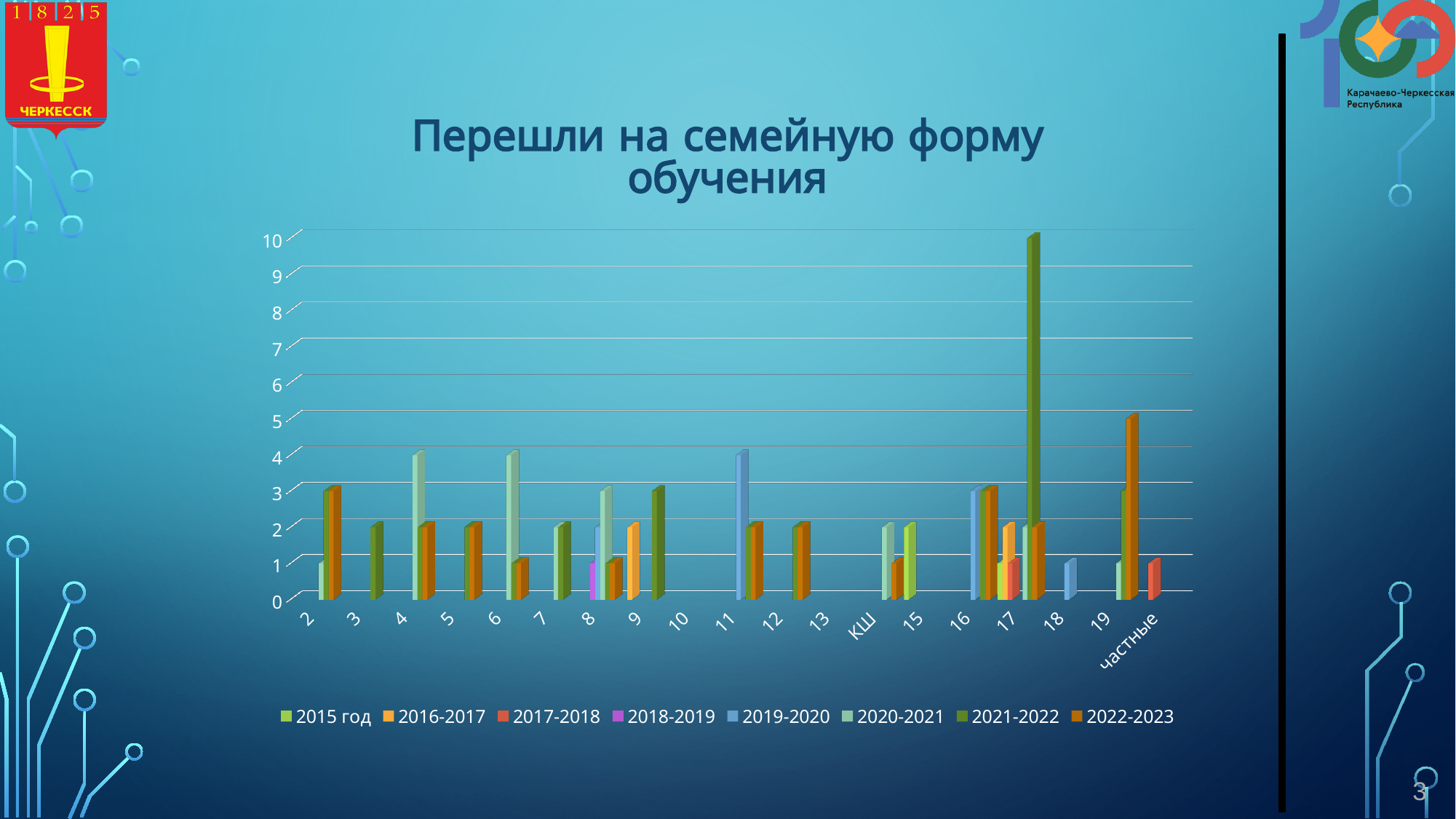
Is the value for 2021-2022 in category 17 greater or less than 8? greater Is the value for 2019-2020 in category 11 greater or less than 3? greater Which category has the tallest bar in the chart? 17 How many categories are shown on the x axis? 19 Which series has the tallest bar for category 17? 2021-2022 What is the title of the chart? Перешли на семейную форму обучения Is the value for 2022-2023 in category 6 greater or less than 3? less Which series has the tallest bar for category частные? 2017-2018 How many series does the legend list? 8 What kind of chart is shown on the slide? bar chart